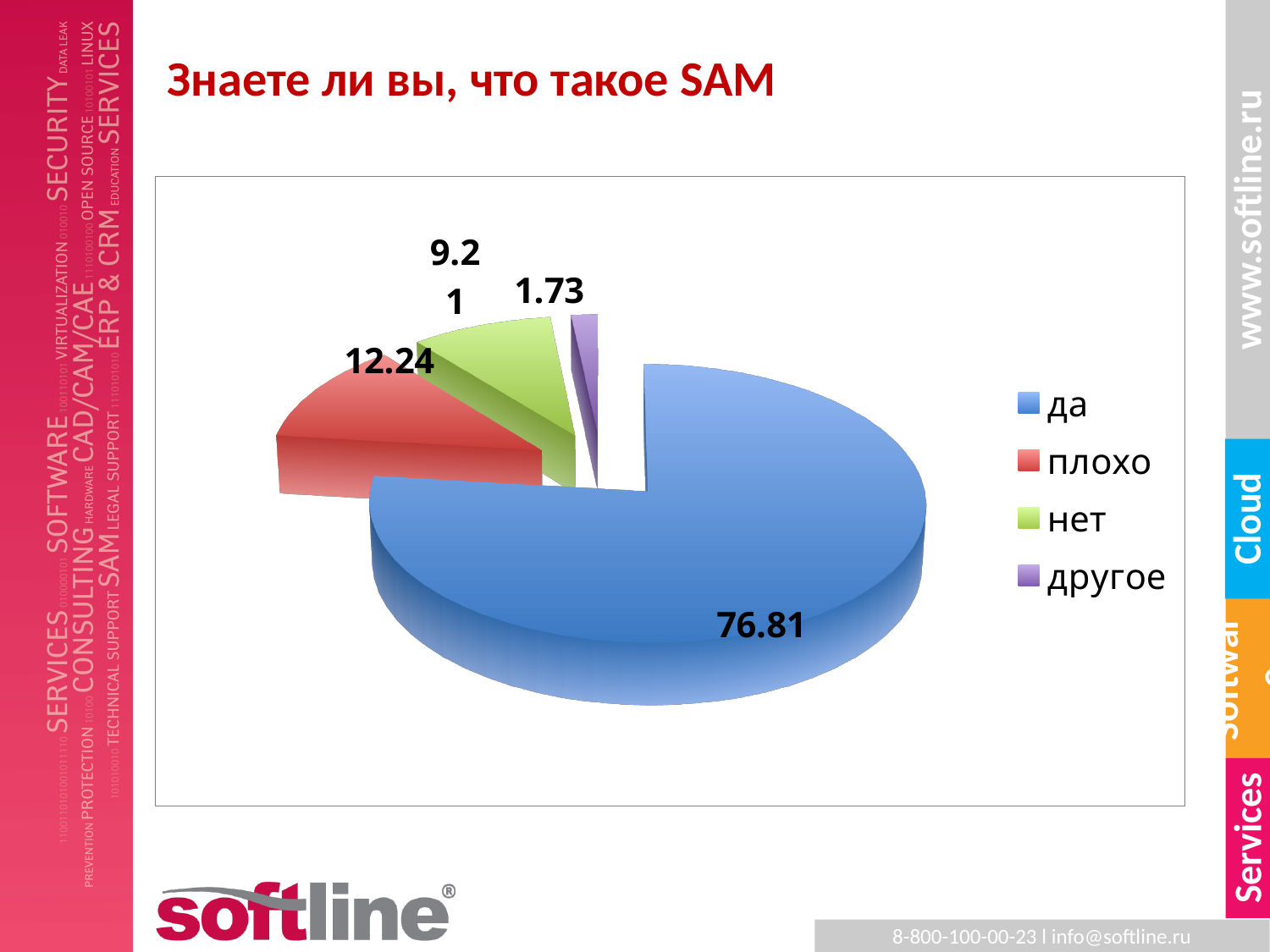
Which category has the smallest slice of the pie? другое What is the difference between the values for "да" and "плохо"? 64.57 What is the value for the "другое" slice? 1.73 What is the title of the slide containing the chart? Знаете ли вы, что такое SAM What is the value for the "да" slice? 76.81 What colour is the "да" slice in the pie chart? blue How many categories does the pie chart have? 4 What kind of chart is shown on the slide? pie chart What is the value for the "плохо" slice? 12.24 What is the difference between the values for "плохо" and "другое"? 10.51 Which category has the largest slice of the pie? да Which is larger, the value for "плохо" or the value for "нет"? плохо